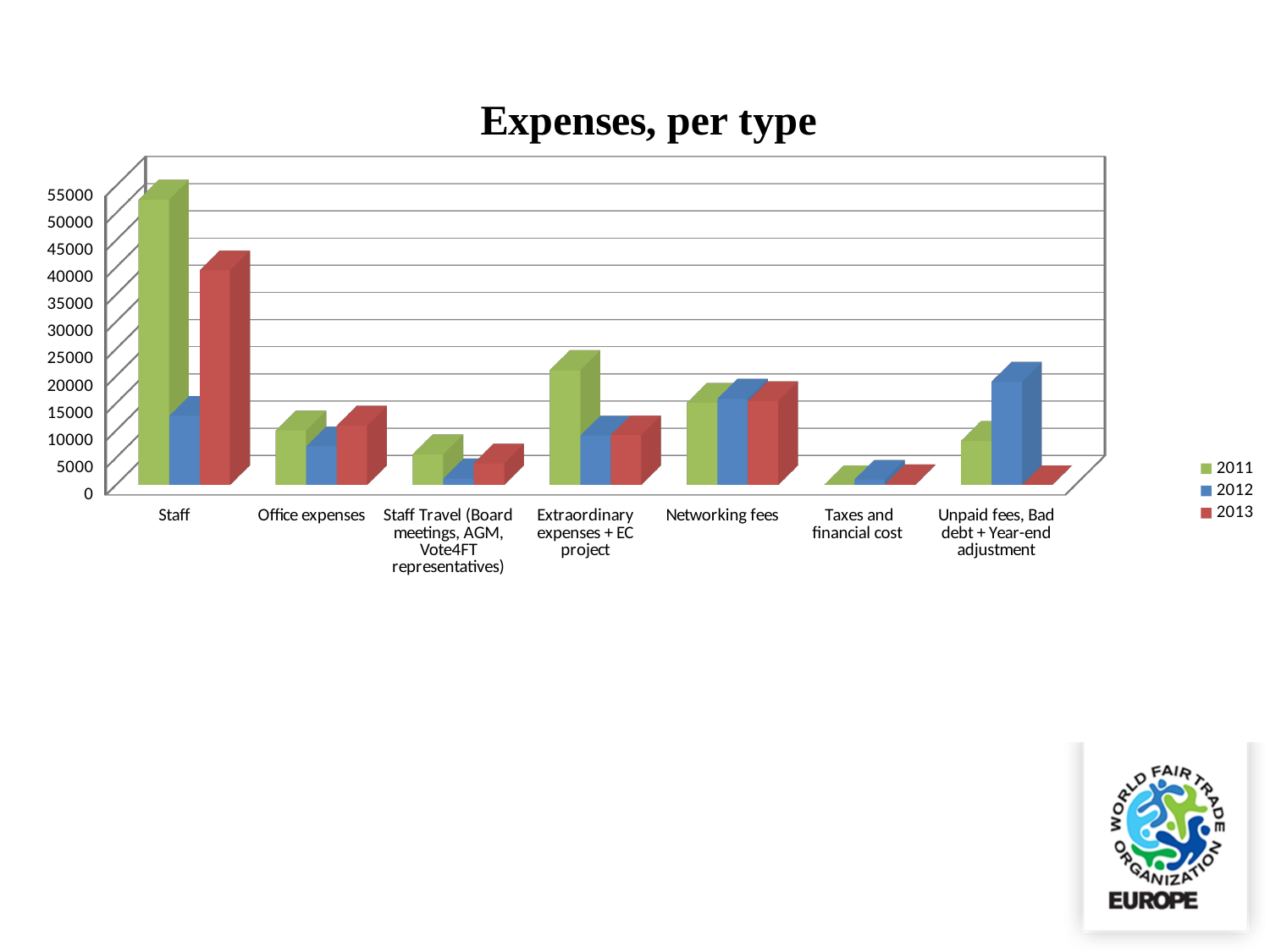
For Staff, which year has the larger value, 2011 or 2013? 2011 For Extraordinary expenses + EC project, which year has the larger value, 2011 or 2012? 2011 How many series does the legend list? 3 Which expense category has the highest value for 2011? Staff Is the 2011 value for Staff greater or less than 50000? greater Is the 2013 value for Staff greater or less than 35000? greater Which expense category has the lowest value for 2011? Taxes and financial cost What kind of chart is shown on the slide? bar chart Is the 2012 value for Staff greater or less than 20000? less What is the title of the chart? Expenses, per type How many expense categories are shown on the x axis? 7